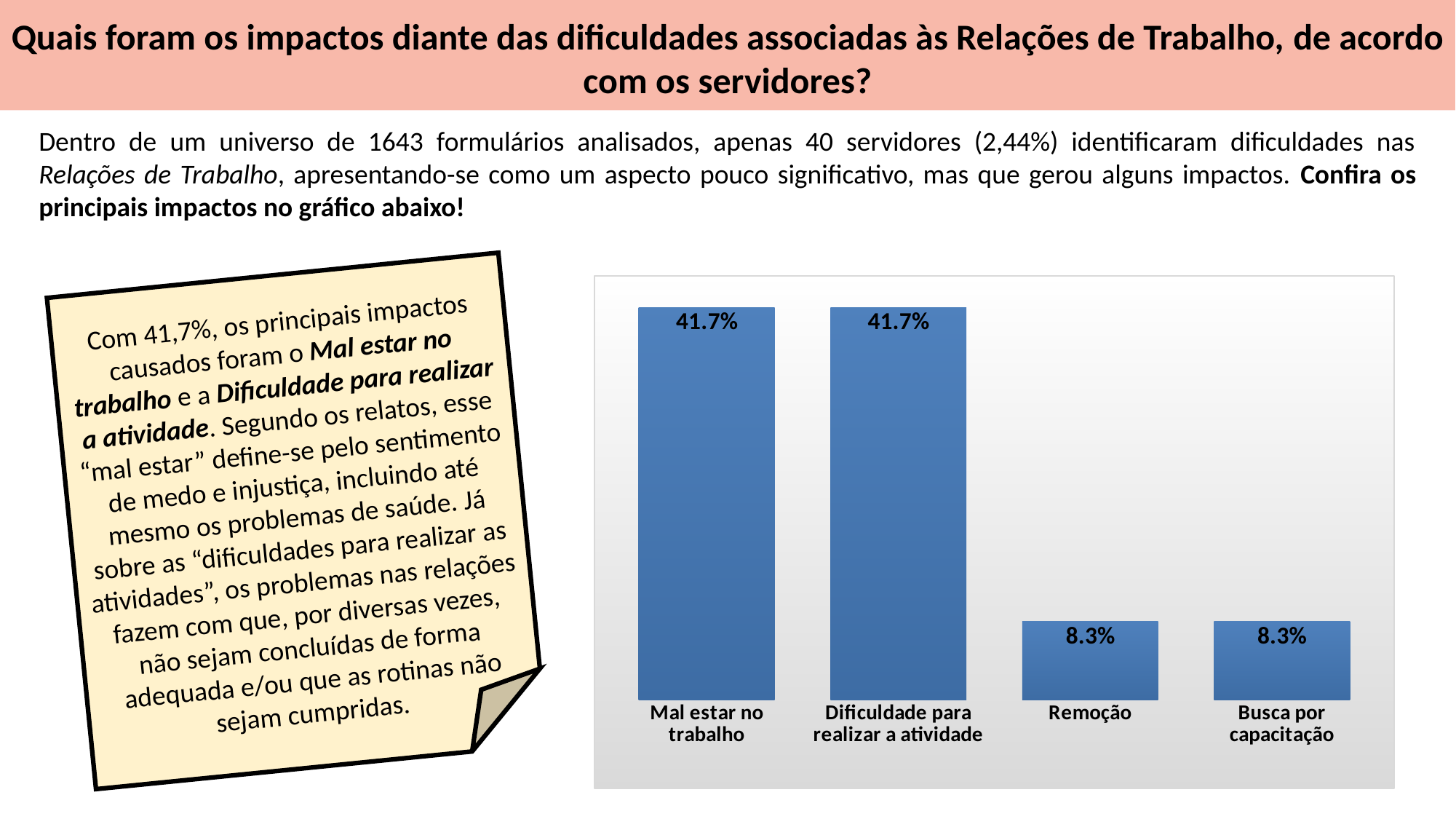
What kind of chart is shown on the slide? Bar chart Do the values rise or fall from left to right across the chart? Fall What is the value for Busca por capacitação? 8.3% What is the difference between the value for Dificuldade para realizar a atividade and the value for Busca por capacitação? 33.4% Which is larger, the value for Mal estar no trabalho or the value for Remoção? Mal estar no trabalho Which is larger, the value for Busca por capacitação or the value for Dificuldade para realizar a atividade? Dificuldade para realizar a atividade What is the value for Remoção? 8.3% What is the difference between the value for Mal estar no trabalho and the value for Remoção? 33.4% What is the value for Dificuldade para realizar a atividade? 41.7% Which two categories share the same value of 41.7%? Mal estar no trabalho and Dificuldade para realizar a atividade What is the value for Mal estar no trabalho? 41.7% How many categories are shown in the chart? 4